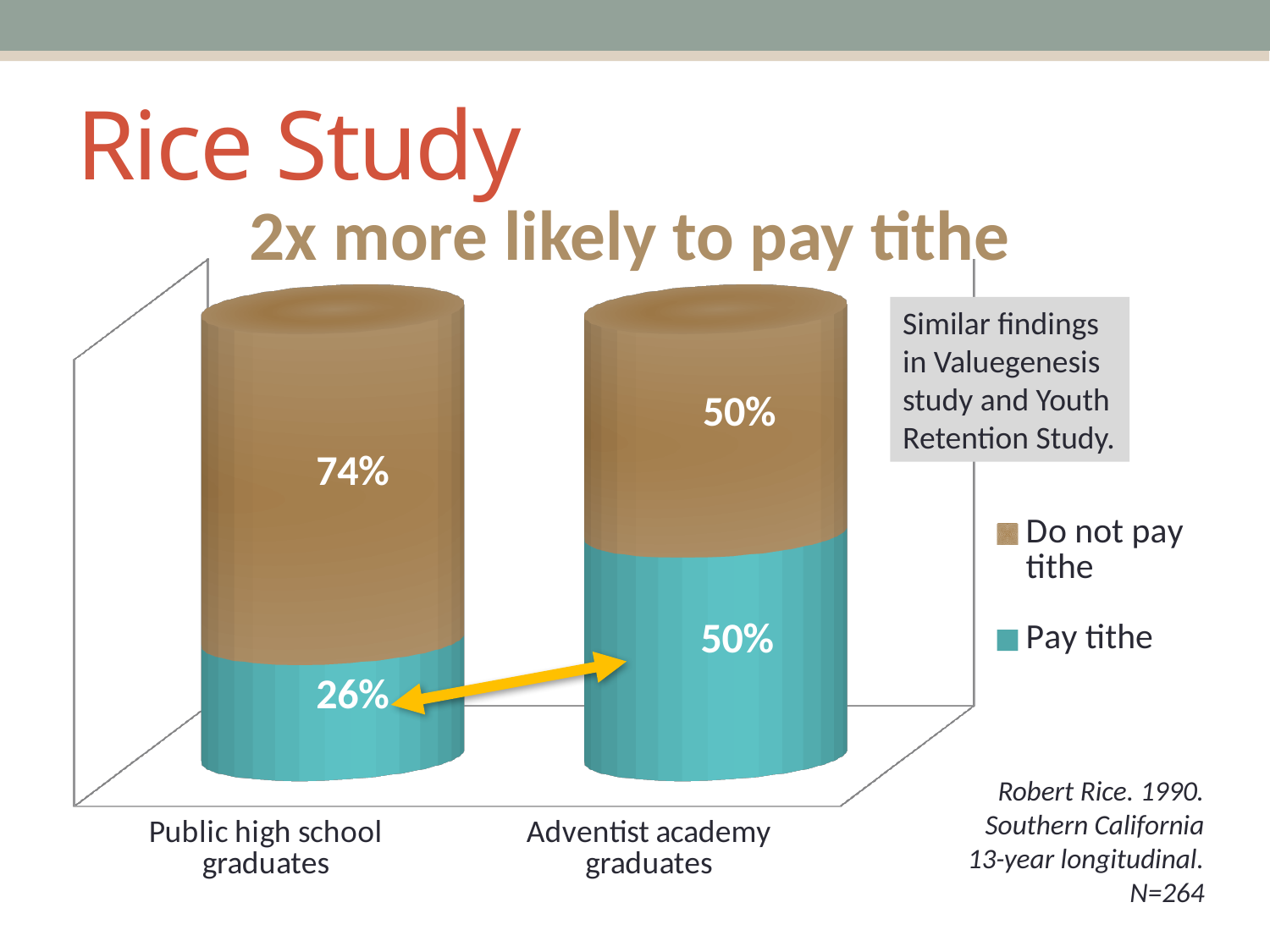
Which group has the lower share paying tithe? Public high school graduates What percentage of Adventist academy graduates do not pay tithe? 50% How many series does the legend list? 2 How many categories are shown on the x axis? 2 What is the difference in the 'Pay tithe' percentage between Adventist academy graduates and public high school graduates? 24% What is the total of the stacked bar for public high school graduates? 100% Is the 'Do not pay tithe' share larger for public high school graduates or Adventist academy graduates? Public high school graduates What percentage of public high school graduates pay tithe? 26% What percentage of public high school graduates do not pay tithe? 74% What kind of chart is shown on the slide? Stacked bar chart Which group has the higher share paying tithe? Adventist academy graduates What percentage of Adventist academy graduates pay tithe? 50%